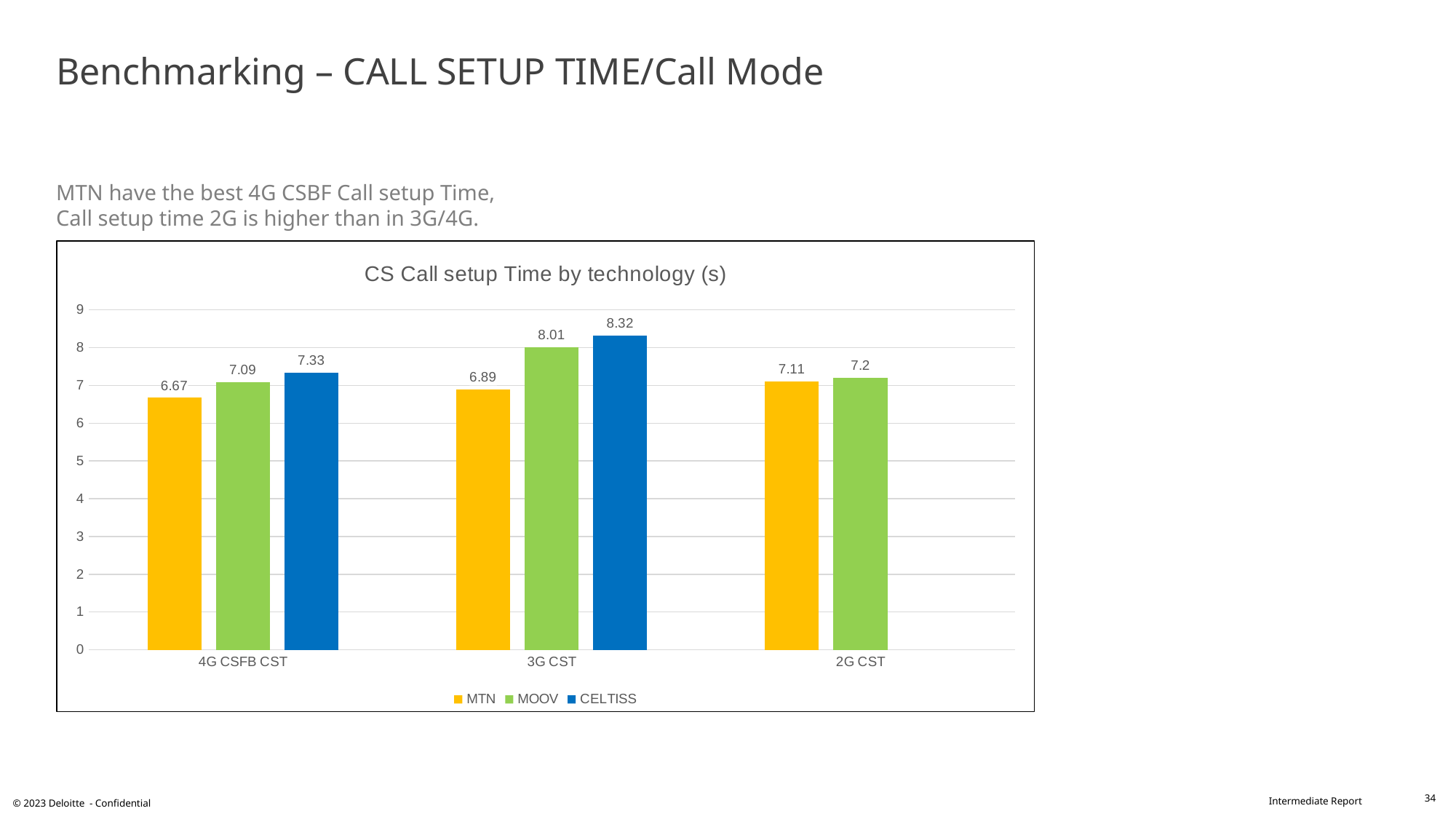
What is the CELTISS value for 3G CST? 8.32 What is the MOOV value for 2G CST? 7.2 What is the title of the chart? CS Call setup Time by technology (s) Which operator has the highest call setup time for 3G CST? CELTISS Which operator has the lowest call setup time for 4G CSFB CST? MTN What is the MTN value for 4G CSFB CST? 6.67 What is the difference between the CELTISS and MTN values for 3G CST? 1.43 Which is larger, the MOOV value for 3G CST or the MOOV value for 2G CST? 3G CST How many technology categories are shown on the x axis? 3 How many series does the legend list? 3 What kind of chart is shown on the slide? bar chart Is the CELTISS value for 3G CST greater or less than 8? greater